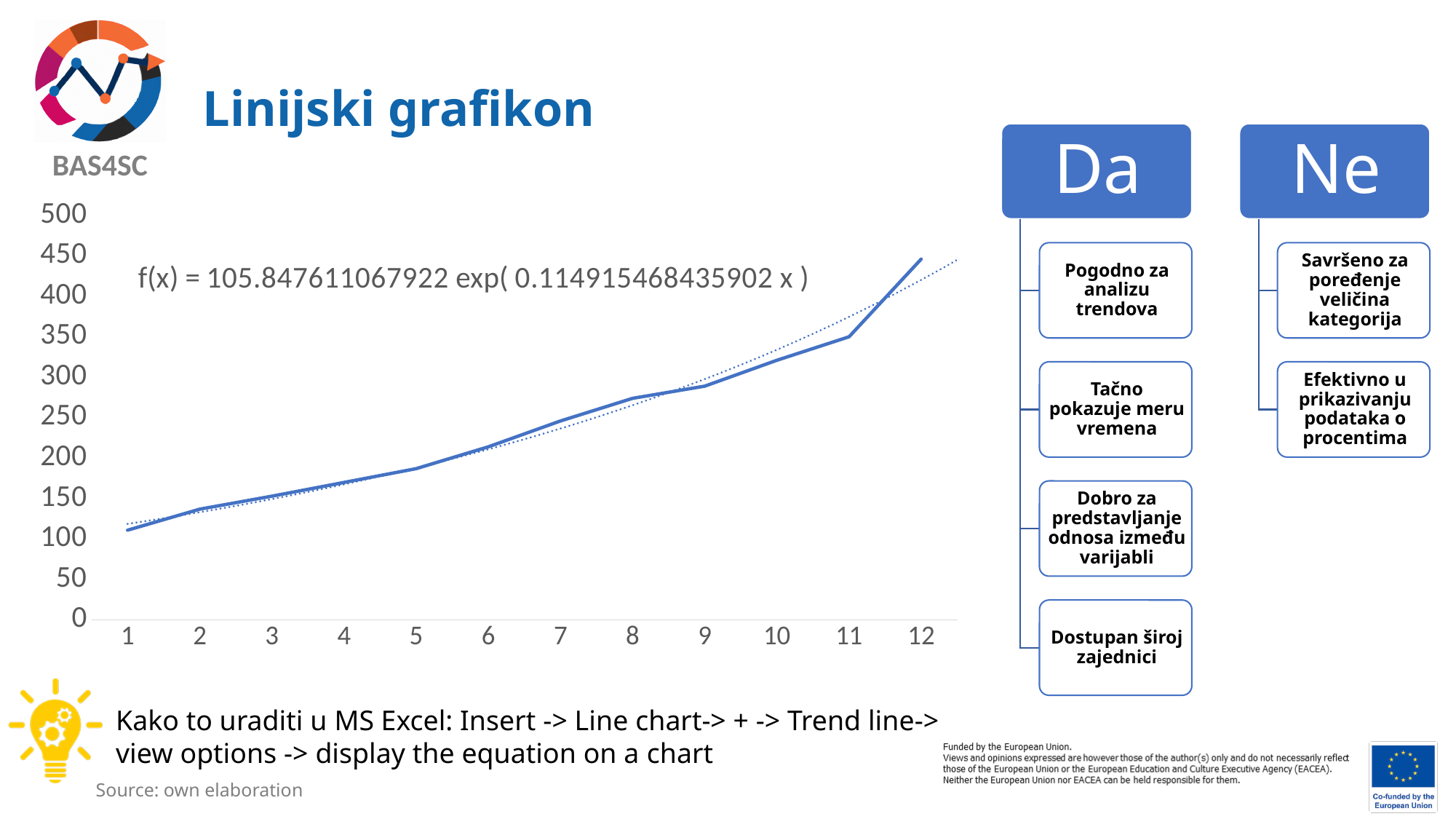
What kind of chart is shown on the slide? line chart What equation is displayed on the chart for the trend line? f(x) = 105.847611067922 exp( 0.114915468435902 x ) Is the value at x = 12 greater or less than 400? greater At which x value does the line reach its highest point? 12 How many points are plotted along the x axis of the line chart? 12 Is the value at x = 6 greater or less than 200? greater Do the values of the line rise or fall as x goes from 1 to 12? rise Is the value at x = 11 greater or less than 400? less Which has the larger value, x = 12 or x = 1? 12 At which x value is the line at its lowest point? 1 What is the title of the slide containing the line chart? Linijski grafikon